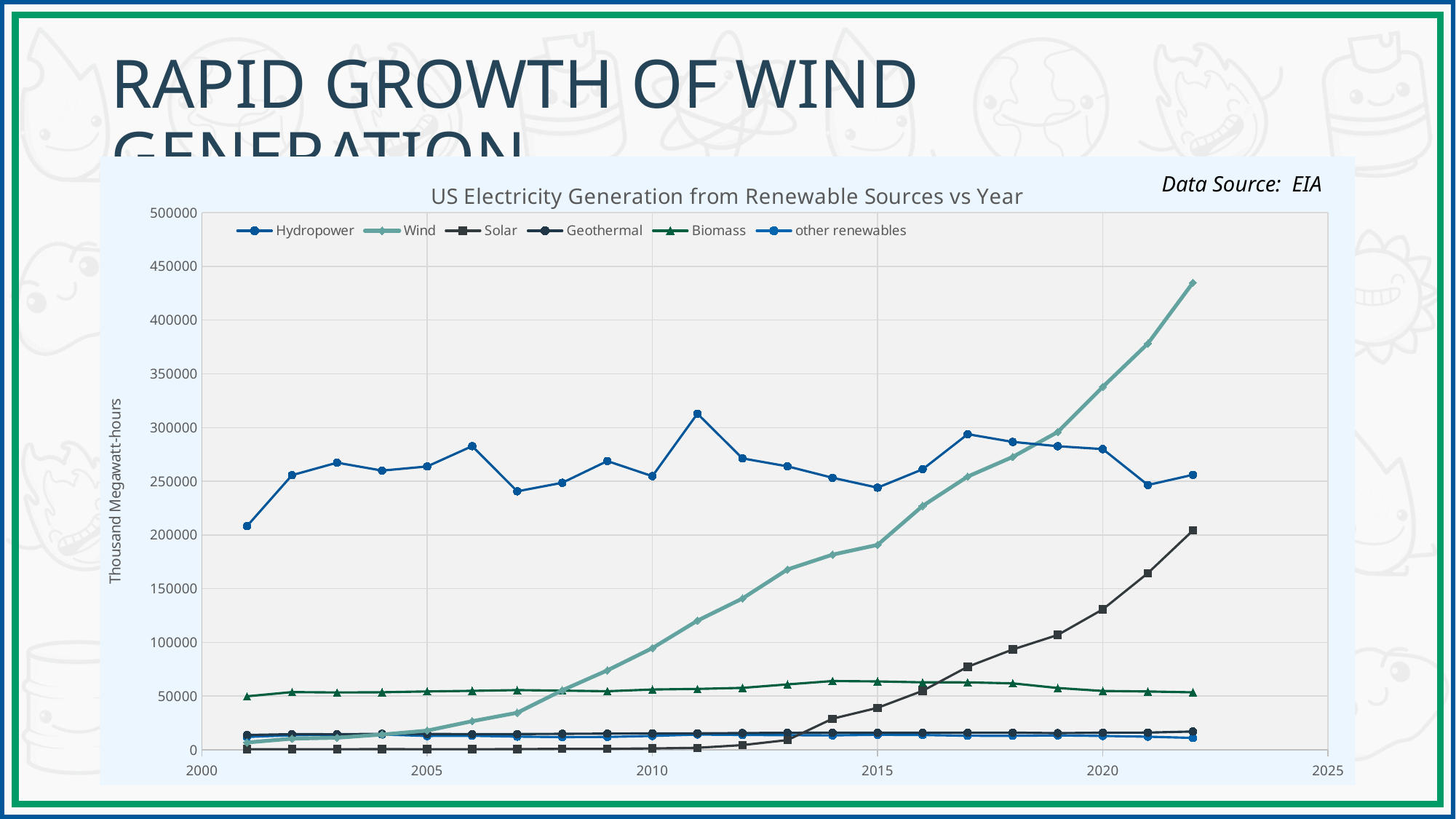
What is the label on the chart's vertical axis? Thousand Megawatt-hours What kind of chart is shown on the slide? line chart Is the value for Biomass in 2022 greater or less than 100000? less Is the value for Solar in 2005 greater or less than 50000? less Is the value for Hydropower in 2011 greater or less than 300000? greater How many series does the chart's legend list? 6 In 2010, which is larger, Hydropower or Wind? Hydropower Which series has the highest value in 2022? Wind In 2022, which is larger, Wind or Hydropower? Wind What is the title of the chart? US Electricity Generation from Renewable Sources vs Year